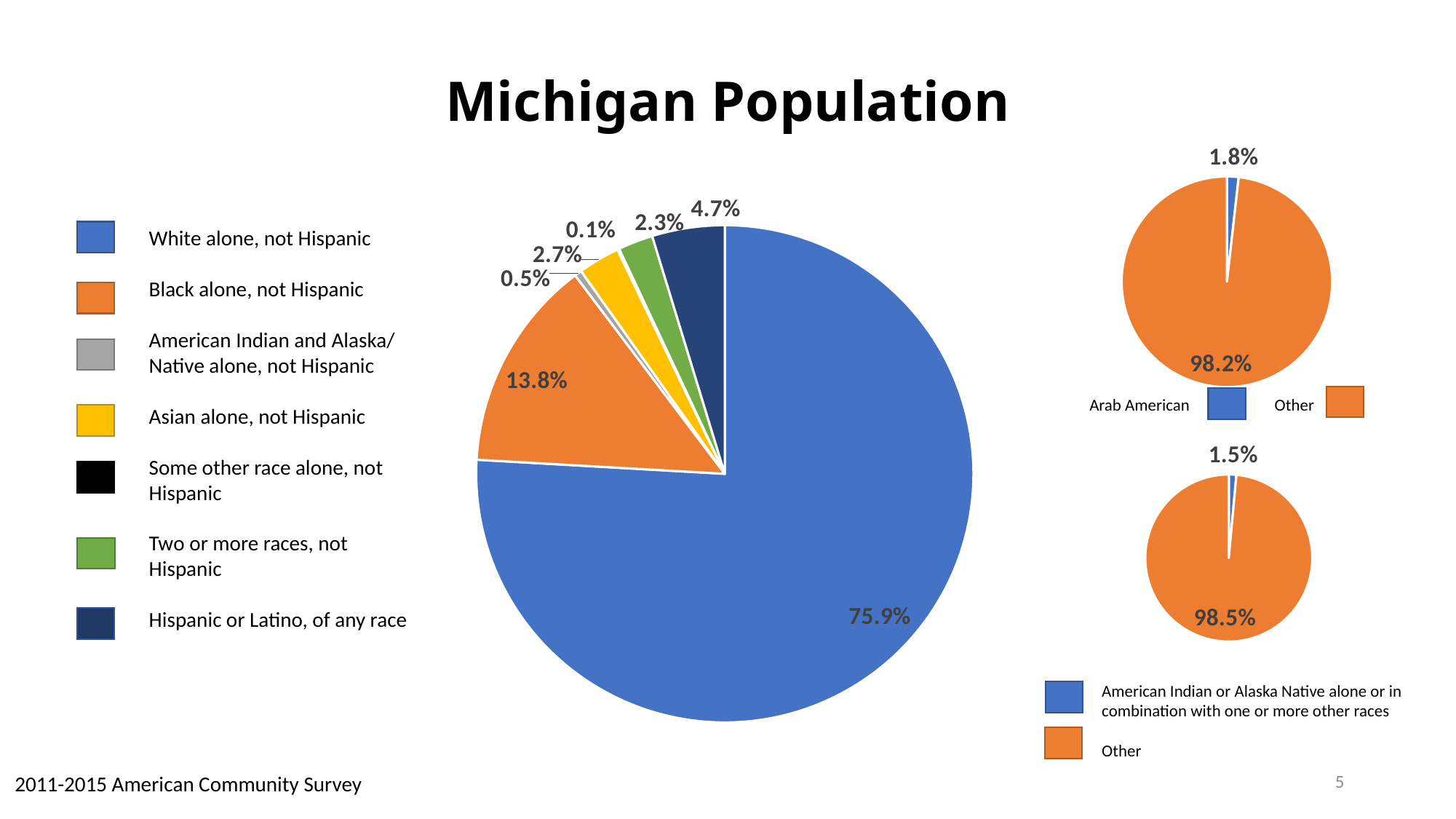
What kind of chart is the large chart in the middle of the slide? Pie chart In the large pie chart, which category has the smallest share? Some other race alone, not Hispanic In the large pie chart, what share is Black alone, not Hispanic? 13.8% In the large pie chart, which category has the largest share? White alone, not Hispanic In the bottom-right small pie chart, what share is American Indian or Alaska Native alone or in combination with one or more other races? 1.5% How many categories does the legend of the large pie chart list? 7 In the large pie chart, what share is Asian alone, not Hispanic? 2.7% In the large pie chart, what is the difference between the White alone, not Hispanic share and the Black alone, not Hispanic share? 62.1% In the large pie chart, which is larger: Two or more races, not Hispanic or Asian alone, not Hispanic? Asian alone, not Hispanic